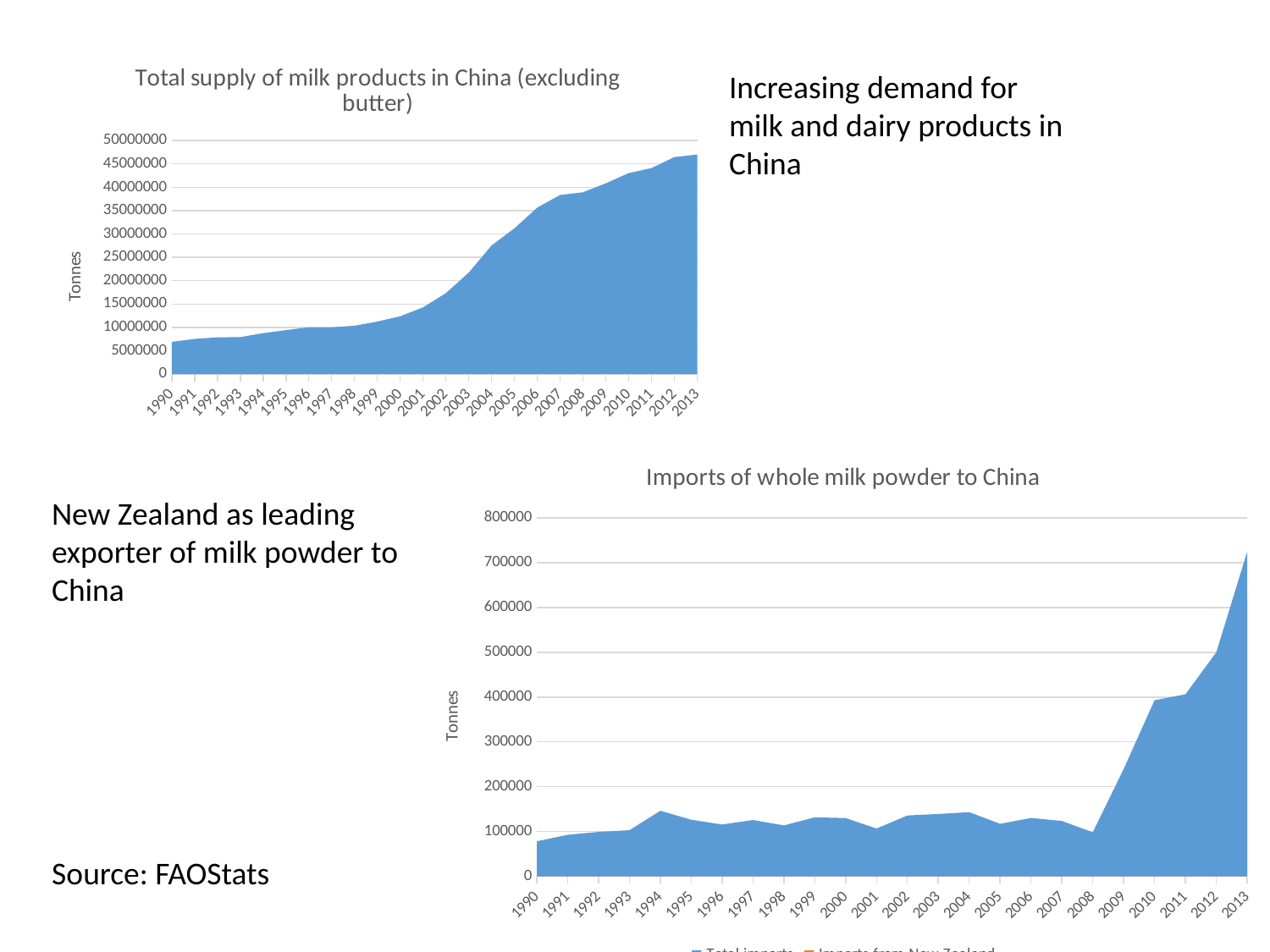
In the 'Imports of whole milk powder to China' chart, is the value for 1990 greater or less than 100000? less In the 'Total supply of milk products in China (excluding butter)' chart, is the value for 2013 greater or less than 45000000? greater In the 'Imports of whole milk powder to China' chart, which year has the highest value? 2013 In the 'Total supply of milk products in China (excluding butter)' chart, how many years are shown on the x axis? 24 In the 'Imports of whole milk powder to China' chart, which is larger, the value for 2009 or the value for 2007? 2009 What is the y-axis label of the 'Imports of whole milk powder to China' chart? Tonnes In the 'Total supply of milk products in China (excluding butter)' chart, which year has the lowest value? 1990 In the 'Total supply of milk products in China (excluding butter)' chart, is the value for 1990 greater or less than 10000000? less In the 'Total supply of milk products in China (excluding butter)' chart, do the values generally rise or fall from 1990 to 2013? Rise In the 'Total supply of milk products in China (excluding butter)' chart, which year has the highest value? 2013 What type of chart is the 'Total supply of milk products in China (excluding butter)' chart? Area chart